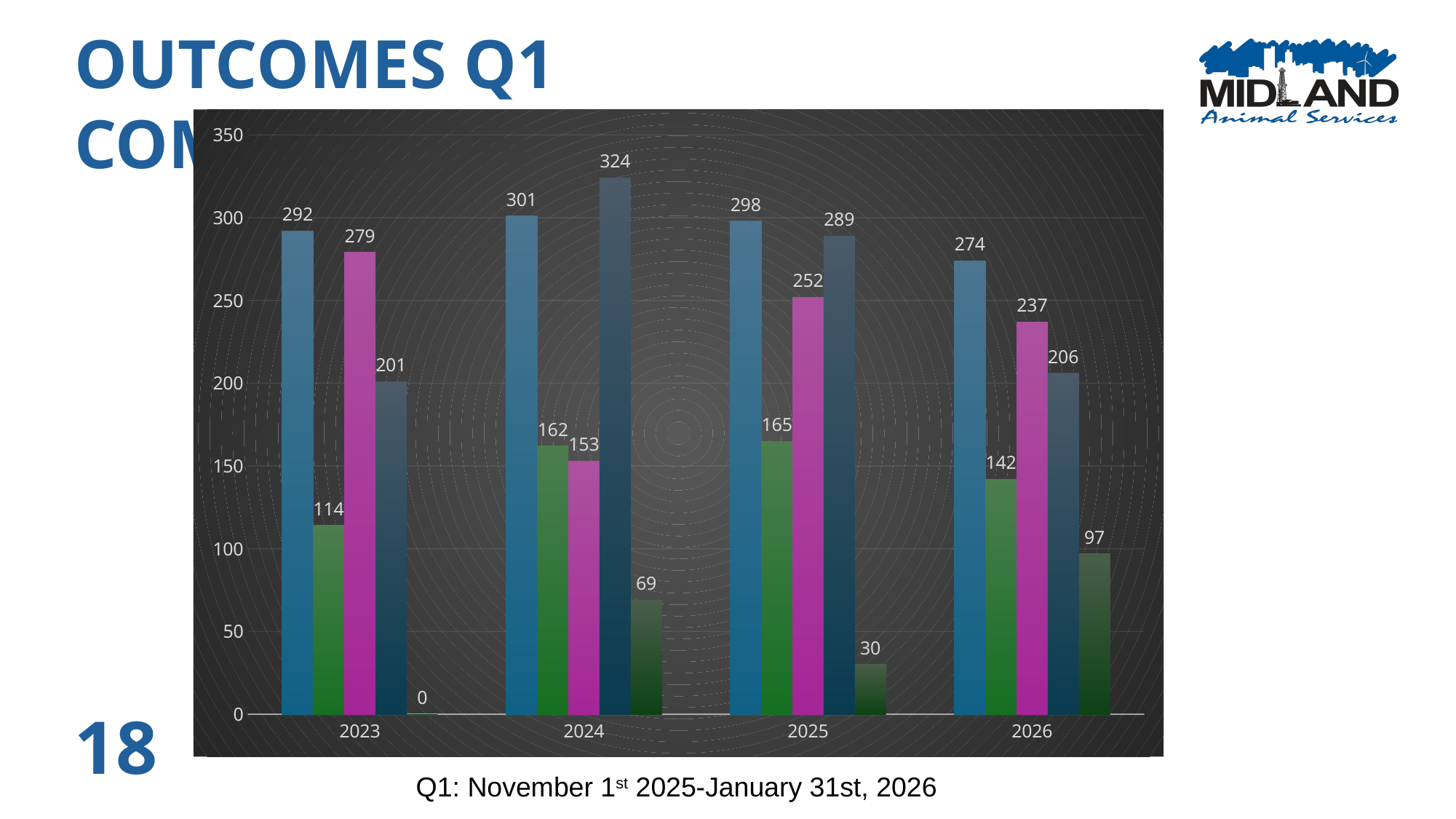
What is the value of the magenta bar for 2025? 252 Does the value of the magenta bar for 2026 rise or fall compared with 2025? fall Which is larger for 2025: the light blue (first) bar or the dark blue (fourth) bar? the light blue bar What is the value of the dark green (last) bar for 2026? 97 What is the value of the dark blue (fourth) bar for 2023? 201 Which year has the highest value for the dark blue (fourth) bar? 2024 Which year has the lowest value for the dark green (last) bar? 2023 What is the highest value shown on the chart's vertical axis? 350 What type of chart is shown on the slide? bar chart What is the value of the light blue (first) bar for 2024? 301 What is the difference between the light blue bar and the green bar for 2023? 178 How many year categories are shown on the x axis of the chart? 4